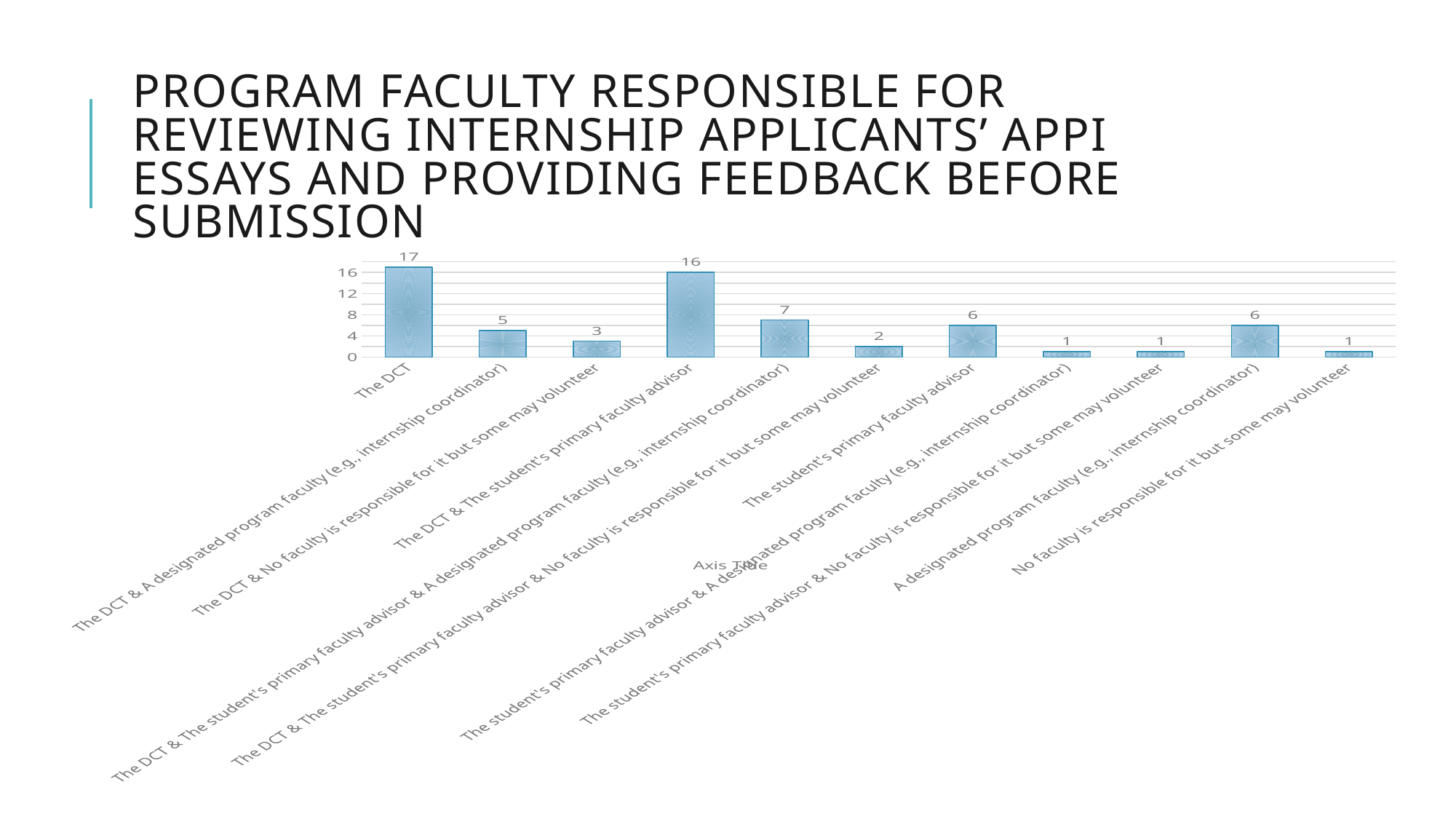
Which category has the highest value? The DCT How many bars are shown in the chart? 11 Is the value for "The DCT & The student's primary faculty advisor & A designated program faculty (e.g., internship coordinator)" greater or less than 4? greater Which is larger: the value for "The DCT & A designated program faculty (e.g., internship coordinator)" or the value for "The student's primary faculty advisor"? The student's primary faculty advisor What is the value for "The DCT"? 17 What is the value for "No faculty is responsible for it but some may volunteer"? 1 What is the value for "The DCT & The student's primary faculty advisor"? 16 What is the highest tick label shown on the vertical axis? 16 What kind of chart is shown on the slide? bar chart What is the difference between the values for "The DCT" and "The DCT & The student's primary faculty advisor"? 1 What is the value for "A designated program faculty (e.g., internship coordinator)"? 6 What is the value for "The DCT & No faculty is responsible for it but some may volunteer"? 3